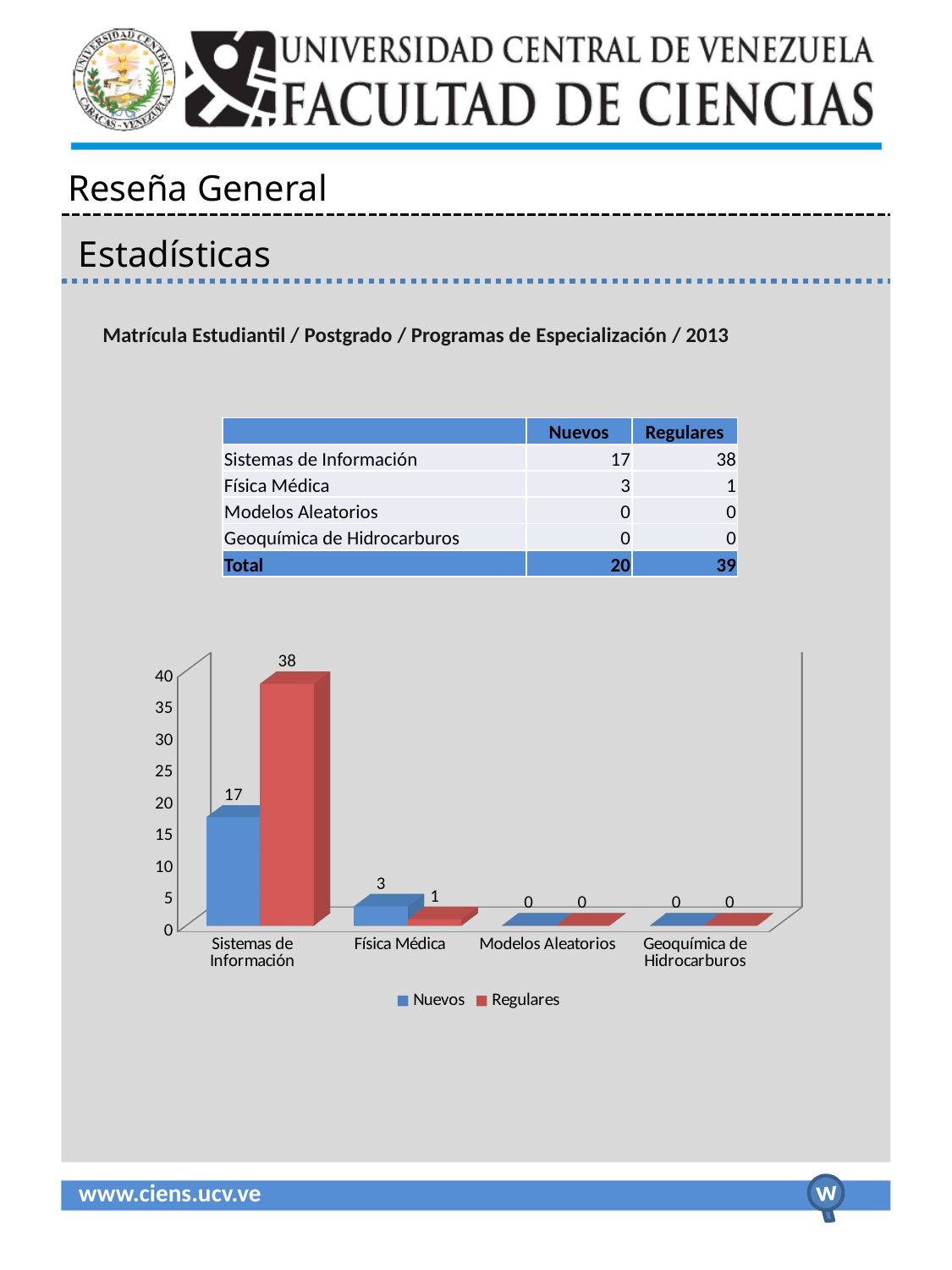
How many categories are shown on the x axis of the chart? 4 What is the Regulares value for Sistemas de Información? 38 What colour represents the Regulares series in the chart? red What is the difference between the Regulares and Nuevos values for Sistemas de Información? 21 How many series does the legend list? 2 What is the Regulares value for Física Médica? 1 Is the Regulares value for Sistemas de Información greater or less than 35? greater What is the Nuevos value for Física Médica? 3 What kind of chart is shown on the slide? bar chart Which is larger for Física Médica, Nuevos or Regulares? Nuevos What is the Nuevos value for Sistemas de Información? 17 Which category has the highest Regulares value? Sistemas de Información